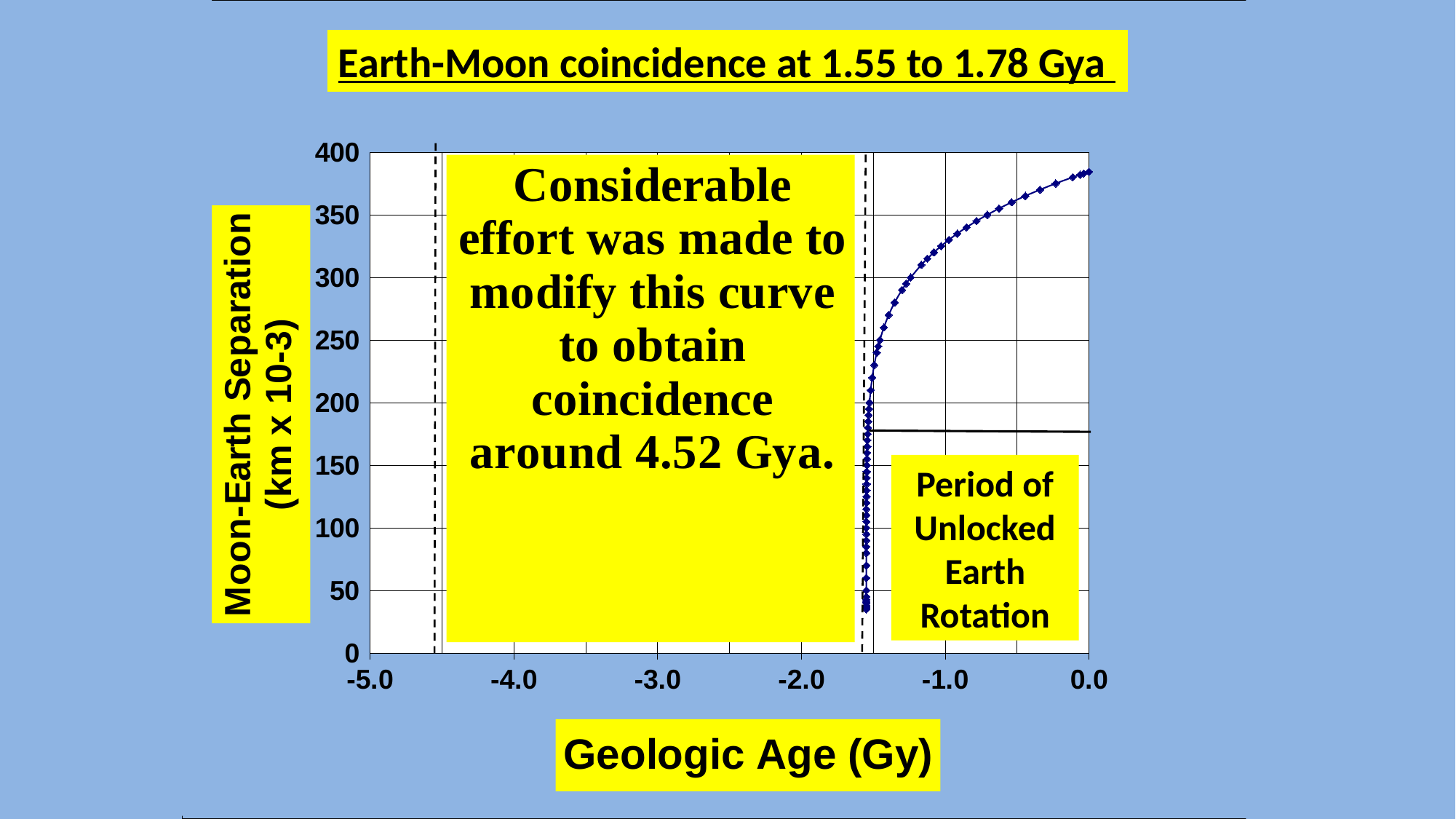
Is the Moon-Earth Separation value at a Geologic Age of 0.0 greater or less than 350? greater What kind of chart is shown on the slide? line chart How many tick labels are shown on the x axis? 6 Is the Moon-Earth Separation value at a Geologic Age of -1.0 greater or less than 300? greater Is the Moon-Earth Separation value at a Geologic Age of -1.5 greater or less than 300? less What is the label of the x axis? Geologic Age (Gy) Does the Moon-Earth Separation rise or fall as Geologic Age goes from -1.5 toward 0.0? rise What is the highest value shown on the y axis? 400 At which Geologic Age does the curve reach its highest Moon-Earth Separation? 0.0 Which has the larger Moon-Earth Separation: Geologic Age -1.0 or Geologic Age 0.0? 0.0 What is the title of the chart on the slide? Earth-Moon coincidence at 1.55 to 1.78 Gya